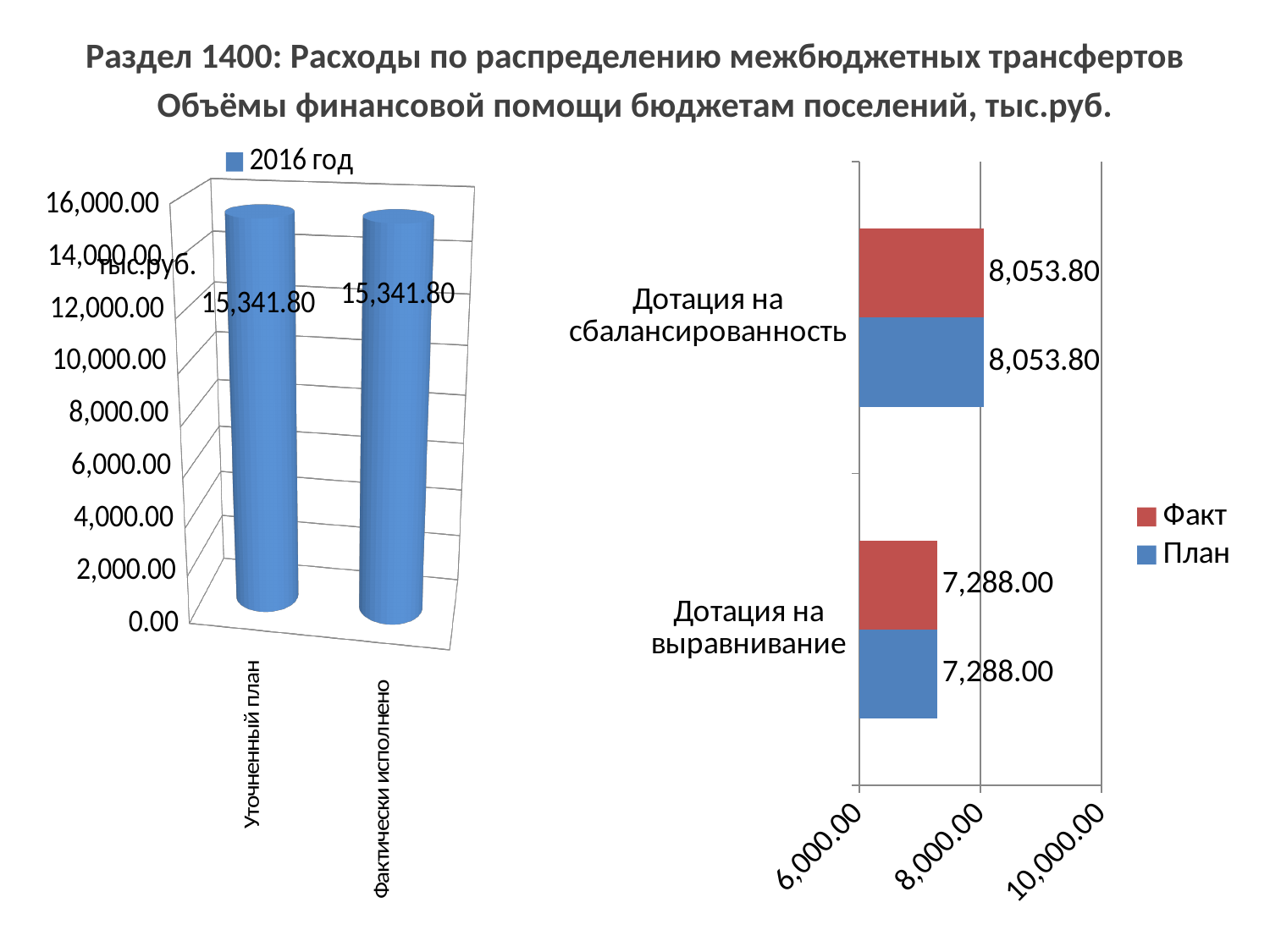
On the left chart, what is the value for Уточненный план? 15,341.80 On the right chart, how many series does the legend list? 2 On the left chart, how many categories are plotted? 2 On the left chart, what is the value for Фактически исполнено? 15,341.80 On the right chart, what is the Факт value for Дотация на сбалансированность? 8,053.80 On the right chart, is the Факт value for Дотация на выравнивание greater or less than 8,000.00? less On the left chart, what is the difference between the values for Уточненный план and Фактически исполнено? 0.00 On the left chart, what series does the legend list? 2016 год On the right chart, what is the difference between the Факт values for Дотация на сбалансированность and Дотация на выравнивание? 765.80 On the right chart, what is the План value for Дотация на выравнивание? 7,288.00 What kind of chart is the right chart? bar chart On the right chart, which category has the higher План value? Дотация на сбалансированность